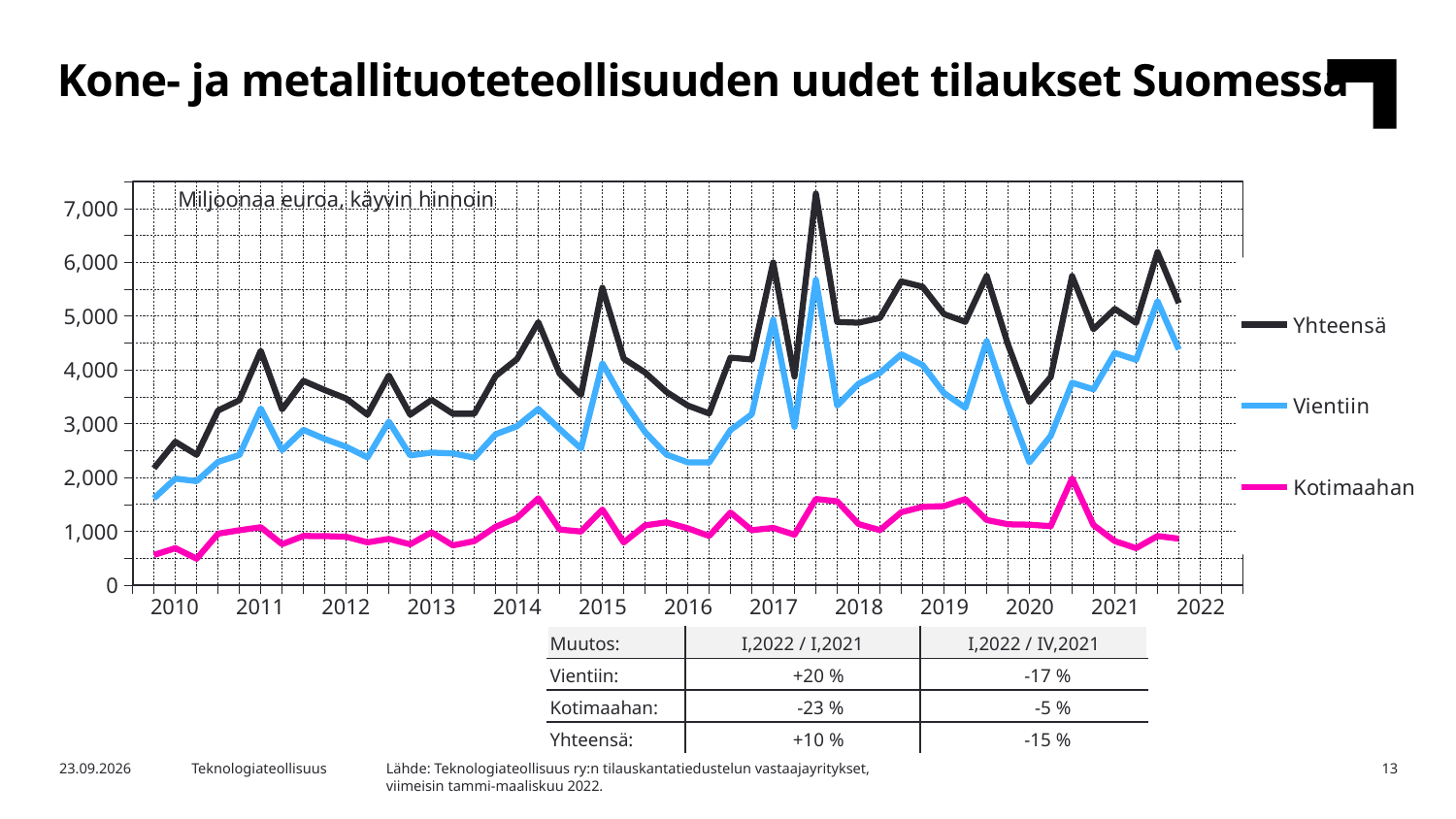
What kind of chart is shown on the slide? line chart Which series has the highest values throughout the chart? Yhteensä Which series has the lowest values throughout the chart? Kotimaahan Is the peak value of the Yhteensä series in 2017 greater or less than 7,000? greater Which series is larger in 2019, Vientiin or Kotimaahan? Vientiin Is the value of the Vientiin series at the start of 2010 greater or less than 2,000? less What are the three series named in the chart legend? Yhteensä, Vientiin, Kotimaahan Is the peak value of the Vientiin series in 2017 greater or less than 5,000? greater Does the Yhteensä series generally rise or fall from 2010 to 2022? rise How many series does the legend of the chart list? 3 What is the title of the chart on the slide? Kone- ja metallituoteteollisuuden uudet tilaukset Suomessa